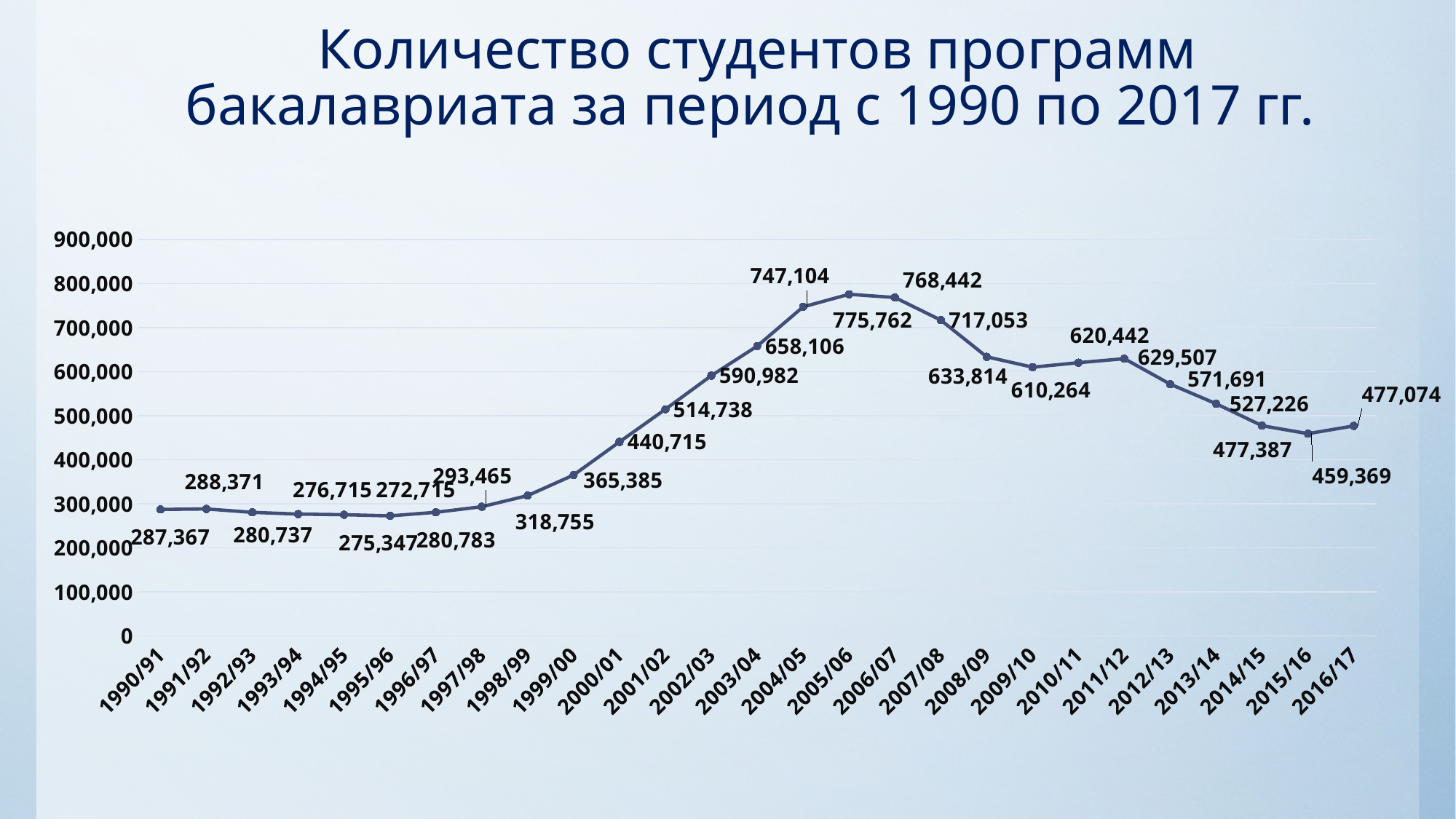
Is the value for 2001/02 greater or less than 500,000? greater What is the number of students for 2005/06? 775,762 Which academic year has the highest number of students? 2005/06 What is the number of students for 1990/91? 287,367 Which academic year has the lowest number of students? 1995/96 How many academic years are plotted on the chart? 27 Do the values rise or fall from 1997/98 to 2005/06? rise What is the difference between the values for 2016/17 and 2015/16? 17,705 What is the number of students for 2016/17? 477,074 What is the difference between the values for 2005/06 and 2004/05? 28,658 Which is larger, the value for 2003/04 or the value for 2008/09? 2003/04 What kind of chart is shown on the slide? line chart